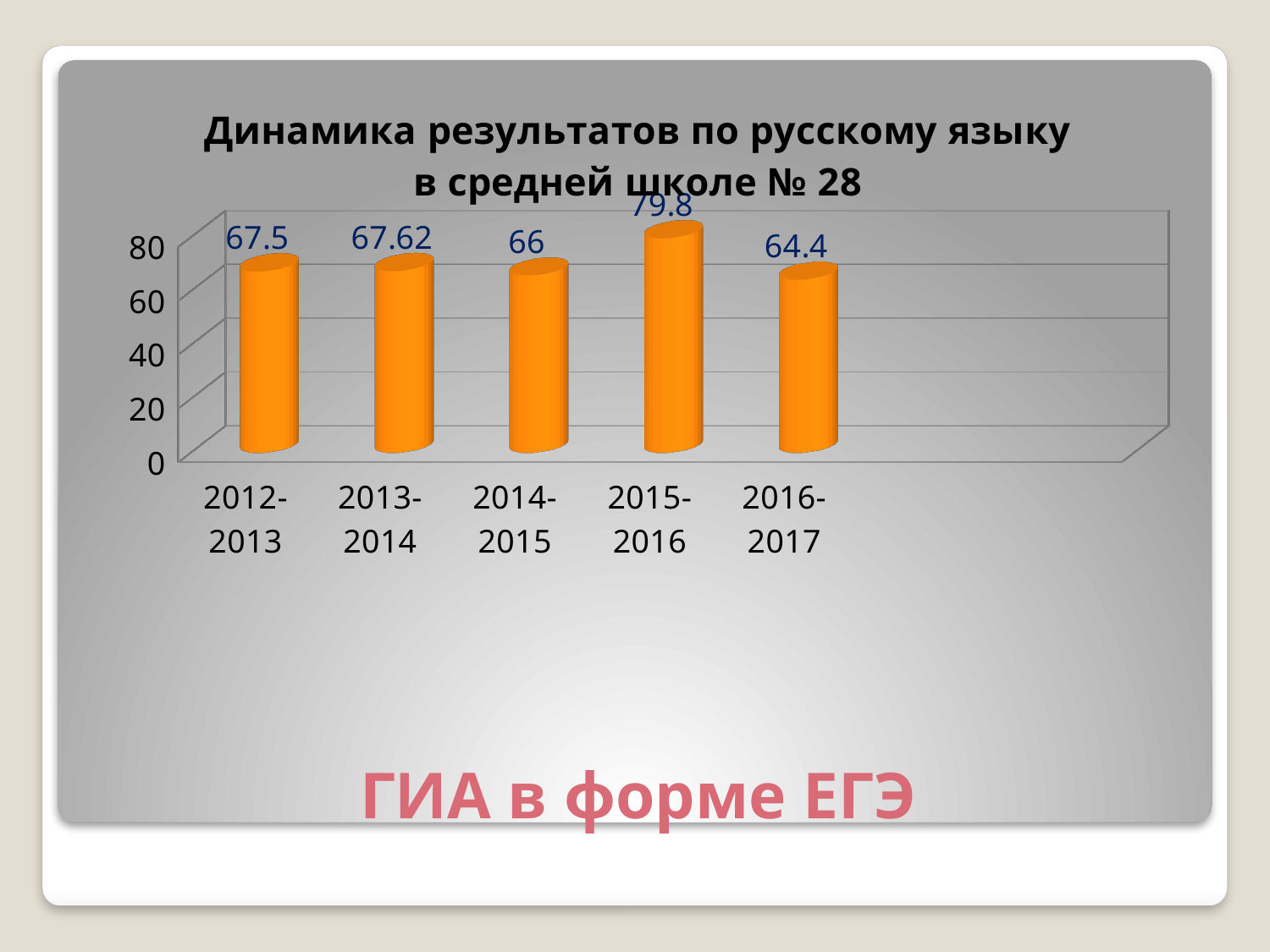
What is the title of the chart? Динамика результатов по русскому языку в средней школе № 28 Does the value rise or fall from 2015-2016 to 2016-2017? Fall What kind of chart is shown on the slide? Bar chart What is the value for 2015-2016? 79.8 How many school years are shown on the chart? 5 What is the difference between the values for 2015-2016 and 2016-2017? 15.4 What is the value for 2014-2015? 66 Which school year has the lowest value? 2016-2017 Which school year has the highest value? 2015-2016 What is the value for 2016-2017? 64.4 Which is larger, the value for 2012-2013 or the value for 2014-2015? 2012-2013 What is the value for 2012-2013? 67.5